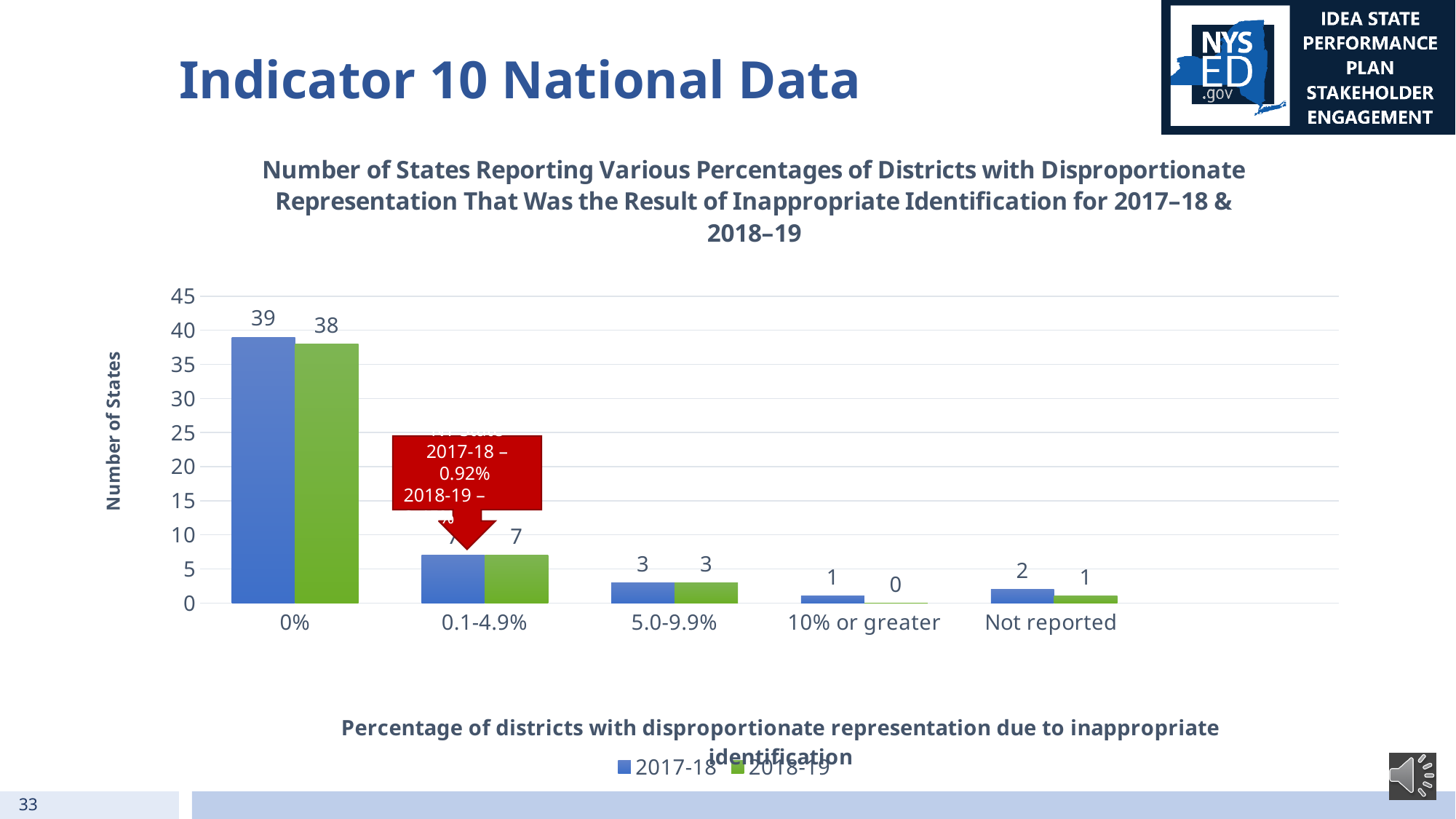
How many categories are shown on the x axis? 5 What is the value for 2017-18 in the 'Not reported' category? 2 How many states are shown for 2018-19 in the '10% or greater' category? 0 In the 'Not reported' category, which series has the larger value, 2017-18 or 2018-19? 2017-18 What is the value for 2018-19 in the 0% category? 38 What is the value for 2017-18 in the 0% category? 39 How many series does the legend list? 2 What is the value for 2018-19 in the 5.0-9.9% category? 3 What kind of chart is shown on the slide? Bar chart What is the difference between the 2017-18 and 2018-19 values in the 0% category? 1 Which category has the highest value for the 2018-19 series? 0% Which category has the lowest value for the 2018-19 series? 10% or greater